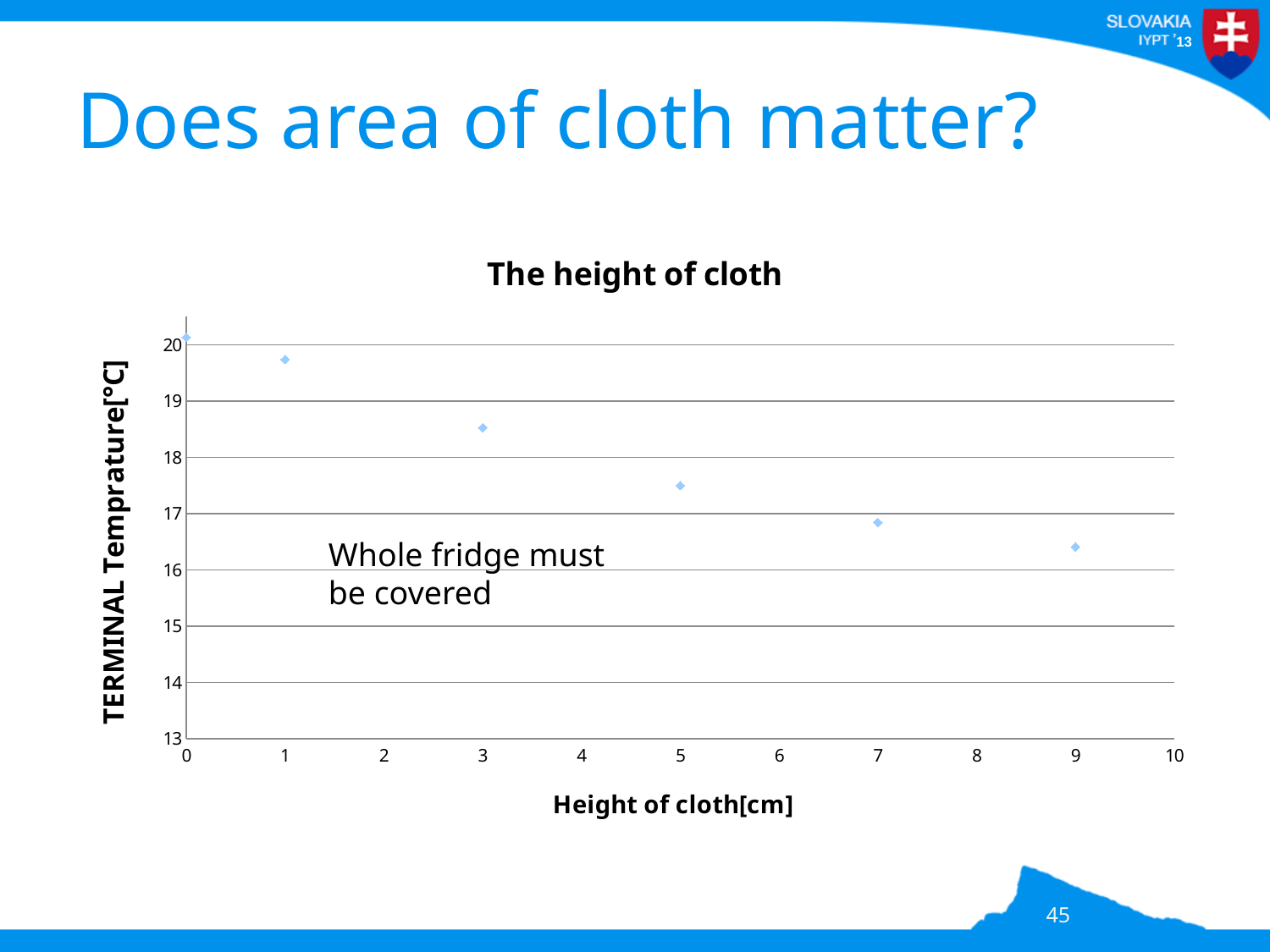
Is the terminal temperature at a cloth height of 7 cm greater or less than 17? less Is the terminal temperature at a cloth height of 5 cm greater or less than 17? greater Is the terminal temperature at a cloth height of 9 cm greater or less than 16? greater Which has the higher terminal temperature: a cloth height of 1 cm or 5 cm? 1 cm At which height of cloth is the terminal temperature highest? 0 Do the terminal temperature values rise or fall as the height of cloth increases? fall At which height of cloth is the terminal temperature lowest? 9 What kind of chart is shown on the slide? scatter chart What is the label of the x axis? Height of cloth[cm] What is the title of the chart? The height of cloth How many data points are plotted on the chart? 6